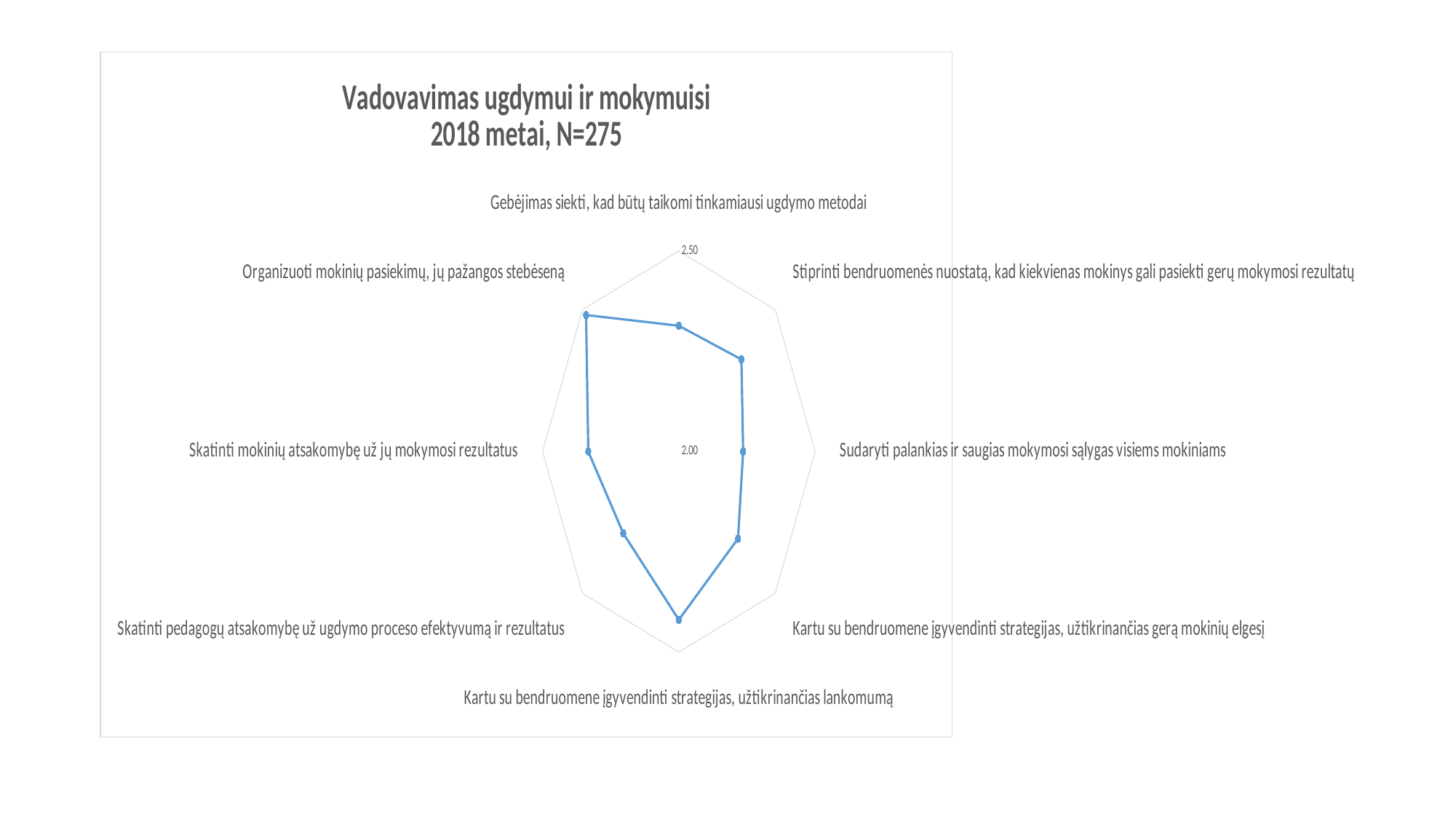
Is the value for "Sudaryti palankias ir saugias mokymosi sąlygas visiems mokiniams" greater or less than 2.50? less Is the value for "Kartu su bendruomene įgyvendinti strategijas, užtikrinančias lankomumą" greater or less than 2.00? greater Which is larger: the value for "Kartu su bendruomene įgyvendinti strategijas, užtikrinančias lankomumą" or for "Skatinti mokinių atsakomybę už jų mokymosi rezultatus"? Kartu su bendruomene įgyvendinti strategijas, užtikrinančias lankomumą What kind of chart is shown on the slide? Radar chart Is the value for "Skatinti pedagogų atsakomybę už ugdymo proceso efektyvumą ir rezultatus" greater or less than 2.00? greater Which is larger: the value for "Gebėjimas siekti, kad būtų taikomi tinkamiausi ugdymo metodai" or for "Sudaryti palankias ir saugias mokymosi sąlygas visiems mokiniams"? Gebėjimas siekti, kad būtų taikomi tinkamiausi ugdymo metodai Which category has the lowest value on the radar chart? Sudaryti palankias ir saugias mokymosi sąlygas visiems mokiniams What is the title of the chart? Vadovavimas ugdymui ir mokymuisi 2018 metai, N=275 What sample size (N) is stated in the chart title? 275 How many categories are plotted on the radar chart? 8